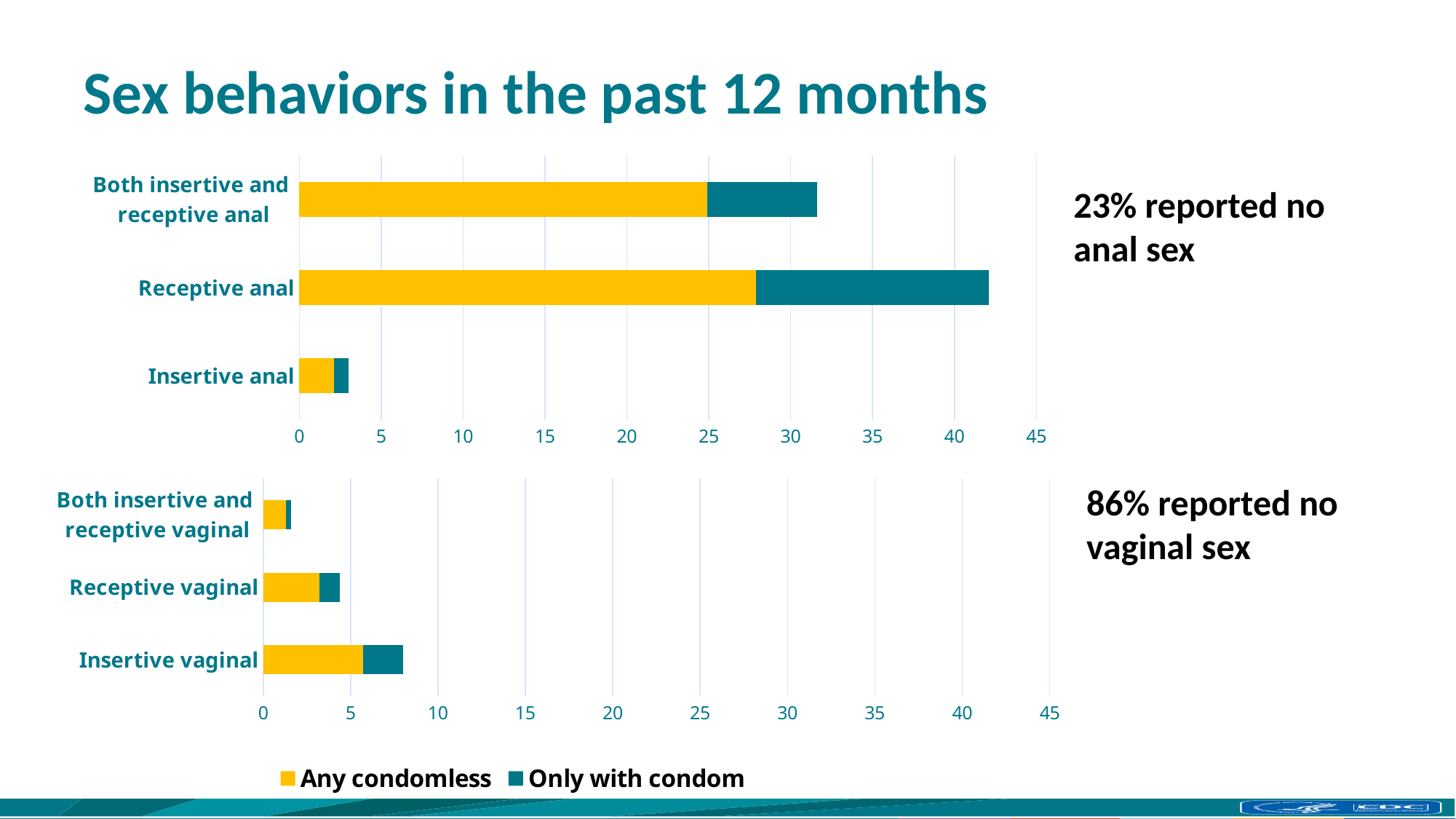
How many categories does the top chart (anal sex behaviors) show? 3 What kind of chart is the top chart on the slide? bar chart In the bottom chart, which total bar is longer: Receptive vaginal or Insertive vaginal? Insertive vaginal How many series does the legend list? 2 In the top chart, is the total bar for Insertive anal greater or less than 5? less Which series is shown in yellow in the legend? Any condomless In the top chart, which category has the shortest total bar? Insertive anal In the bottom chart, which category has the longest total bar? Insertive vaginal In the bottom chart, which category has the shortest total bar? Both insertive and receptive vaginal In the bottom chart, is the total bar for Insertive vaginal greater or less than 5? greater In the top chart, which category has the longest total bar? Receptive anal In the top chart, is the total bar for Receptive anal greater or less than 40? greater